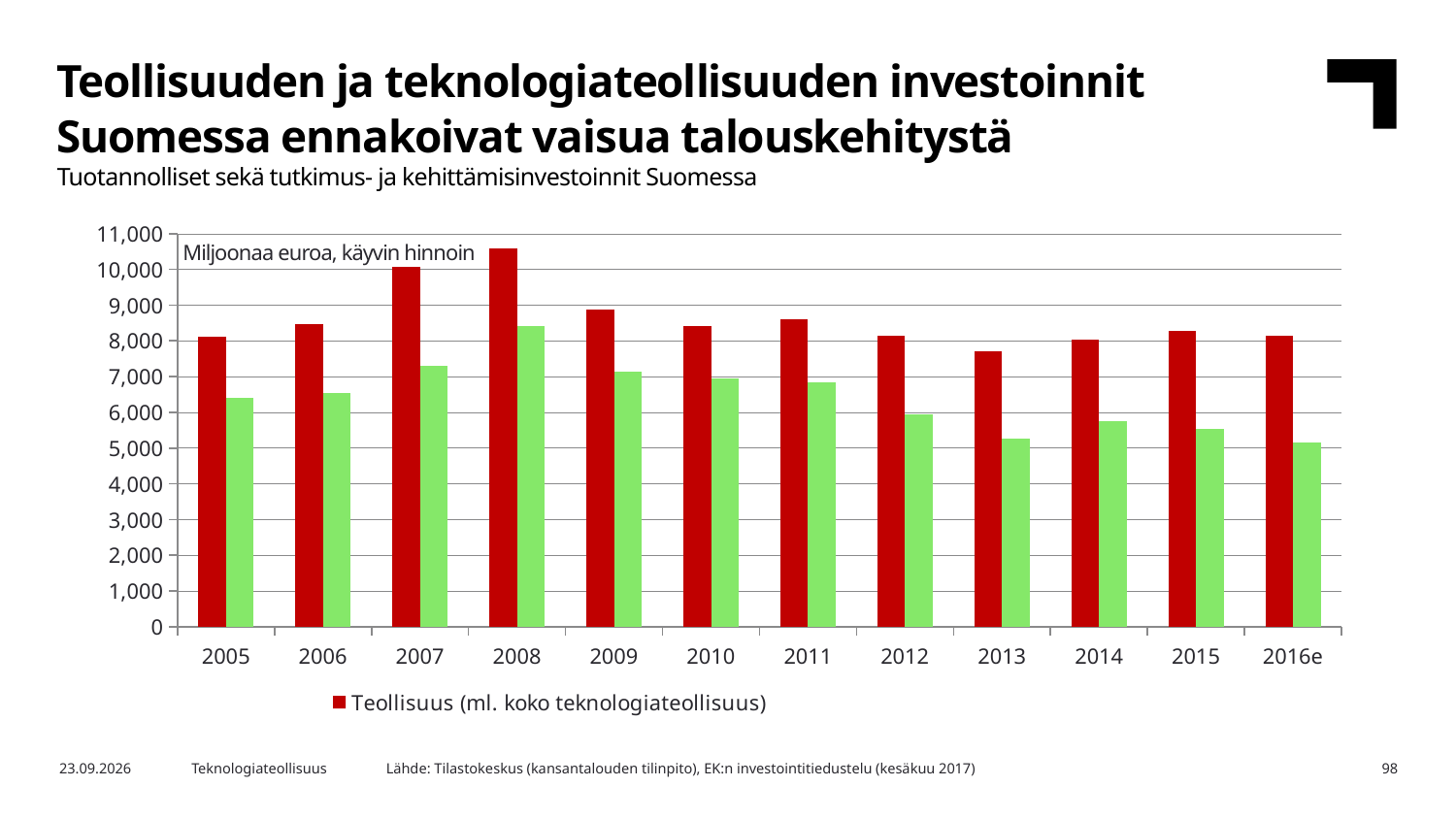
Which year has the larger value for Teollisuus (ml. koko teknologiateollisuus), 2009 or 2010? 2009 Is the value for Teollisuus (ml. koko teknologiateollisuus) in 2013 greater or less than 8,000? less Is the value for Teollisuus (ml. koko teknologiateollisuus) in 2008 greater or less than 10,000? greater In which year is the value for Teollisuus (ml. koko teknologiateollisuus) lowest? 2013 Is the value for Teollisuus (ml. koko teknologiateollisuus) in 2009 greater or less than 8,000? greater How many years (categories) are shown on the x axis? 12 Which year has the larger value for Teollisuus (ml. koko teknologiateollisuus), 2013 or 2014? 2014 Do the values for Teollisuus (ml. koko teknologiateollisuus) rise or fall from 2008 to 2013? fall What unit label is printed inside the chart area? Miljoonaa euroa, käyvin hinnoin In which year is the value for Teollisuus (ml. koko teknologiateollisuus) highest? 2008 What kind of chart is shown on the slide? Bar chart How many series does the legend list? 1